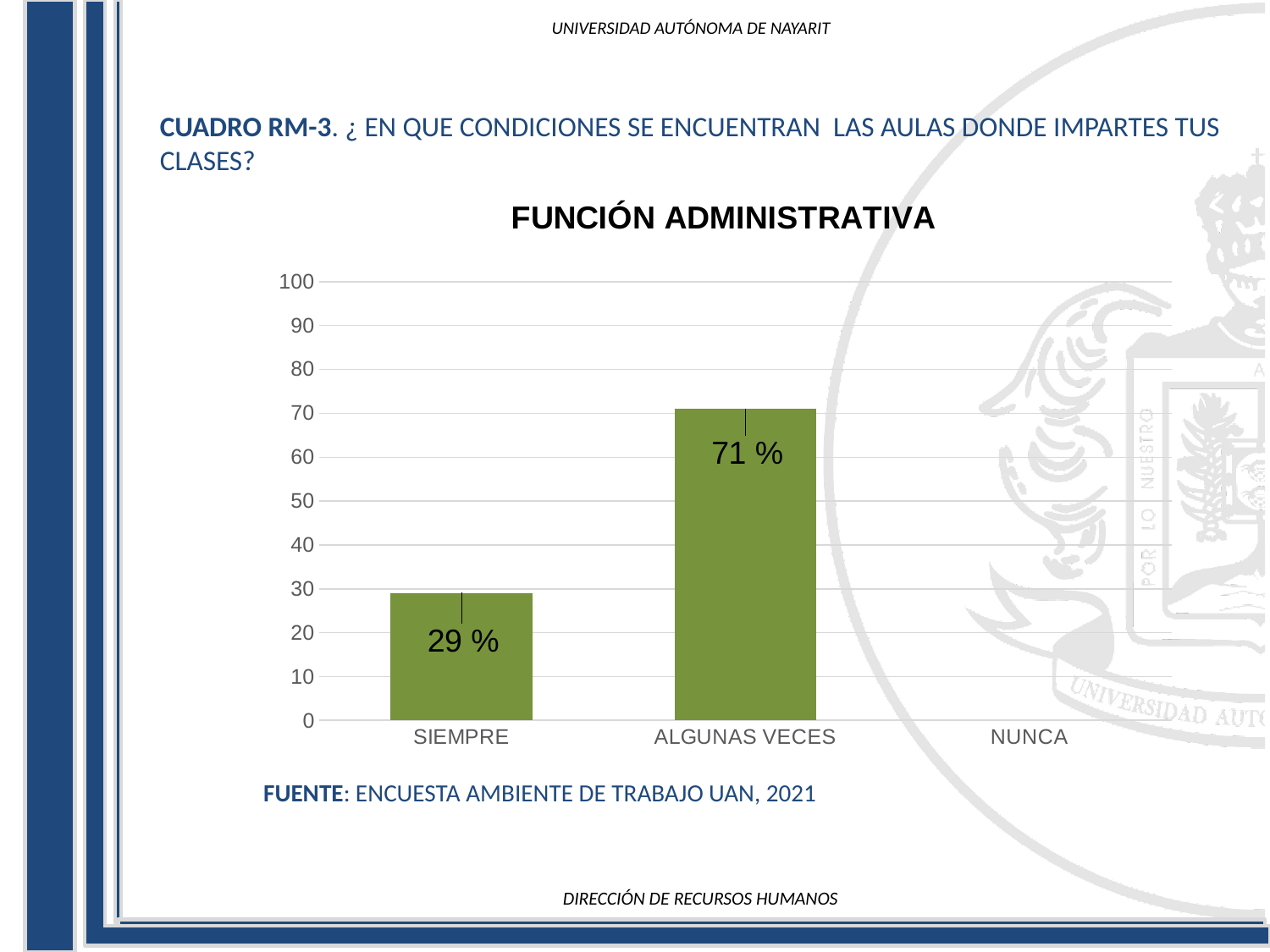
Is the value for ALGUNAS VECES greater or less than 60? greater What is the difference between the values for ALGUNAS VECES and SIEMPRE? 42 % Is the value for SIEMPRE greater or less than 40? less What is the title of the chart? FUNCIÓN ADMINISTRATIVA What kind of chart is shown? bar chart What is the maximum value shown on the y axis? 100 Which is larger, the value for SIEMPRE or the value for ALGUNAS VECES? ALGUNAS VECES What is the value for SIEMPRE? 29 % What is the value for ALGUNAS VECES? 71 % How many categories are shown on the x axis? 3 Which category has the highest value? ALGUNAS VECES